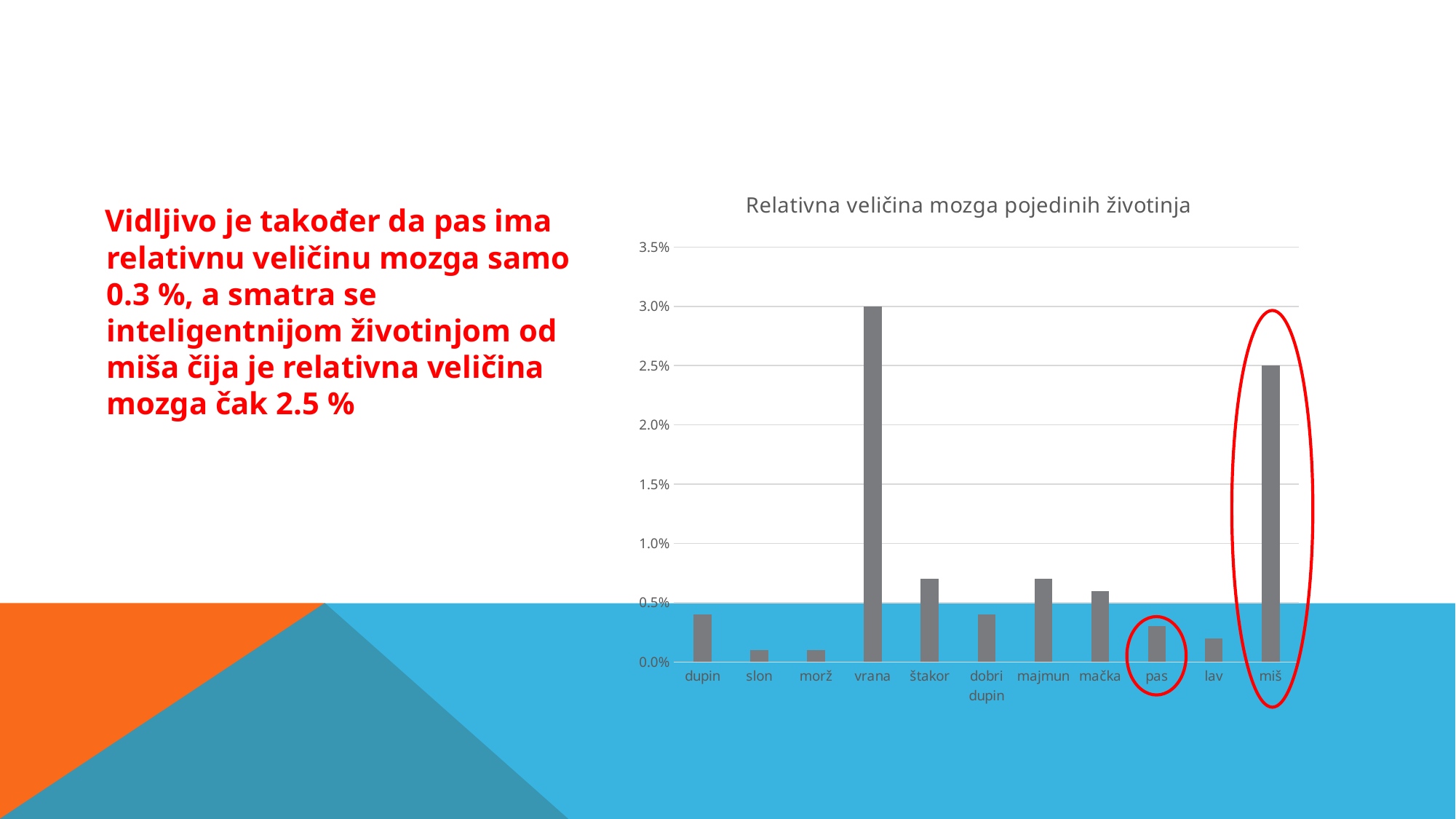
What type of chart is shown on the slide? bar chart Is the value for štakor greater or less than 0.5%? greater Which two categories on the chart are circled in red? pas and miš Is the value for lav greater or less than 0.5%? less Is the value for dupin greater or less than 0.5%? less How many animal categories are shown on the x axis of the chart? 11 What is the title of the chart? Relativna veličina mozga pojedinih životinja What is the value for vrana in the chart? 3.0% What is the value for miš in the chart? 2.5% Which animal has the highest relative brain size in the chart? vrana What is the difference between the values for vrana and miš? 0.5% Which is larger, the value for vrana or the value for miš? vrana